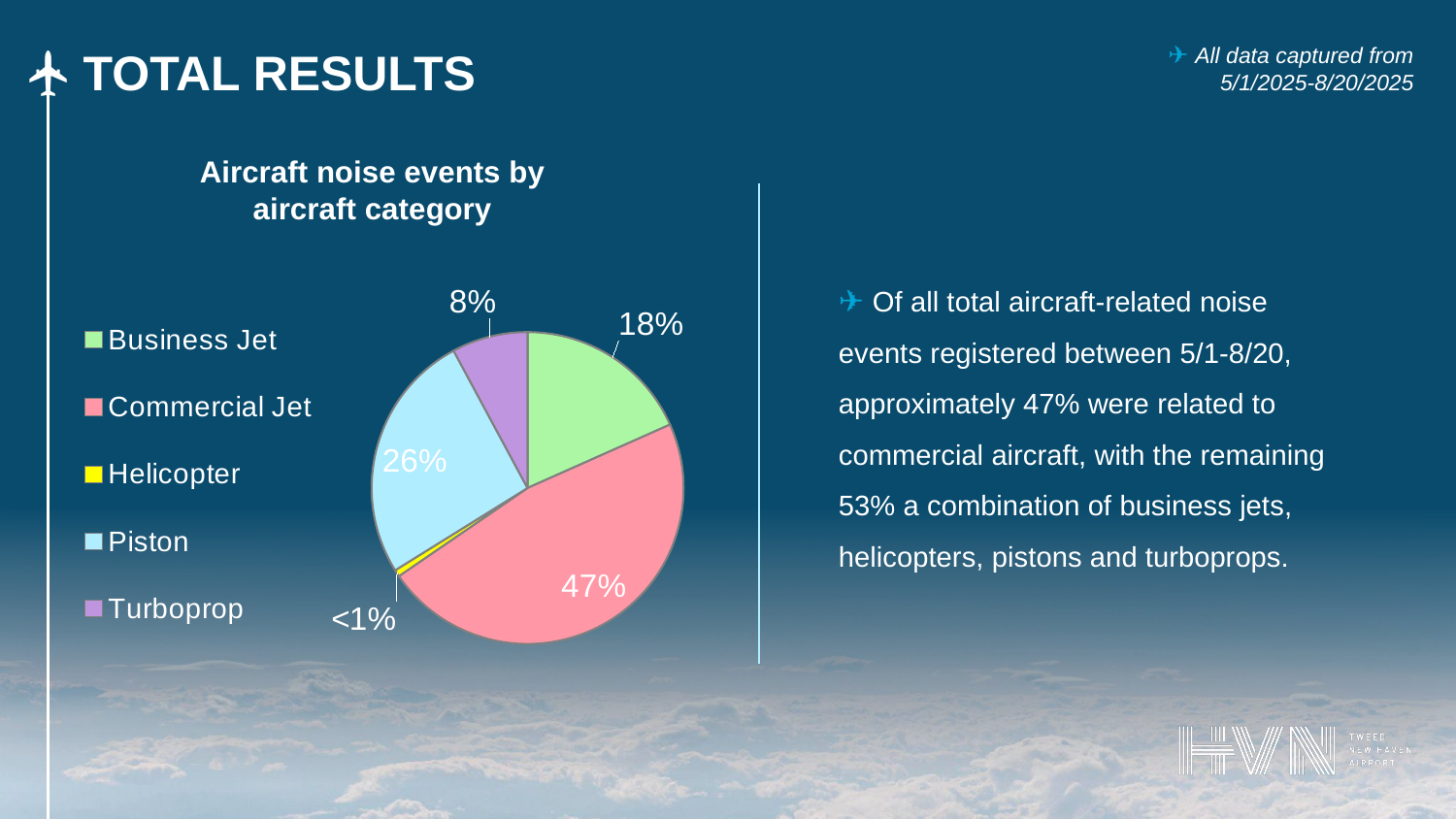
What share of aircraft noise events is attributed to Helicopter? <1% What share of aircraft noise events is attributed to Turboprop? 8% What is the difference in percentage points between the Commercial Jet and Piston shares? 21 What share of aircraft noise events is attributed to Business Jet? 18% Which has a larger share of noise events, Piston or Business Jet? Piston Which aircraft category has the largest share of noise events? Commercial Jet What kind of chart is shown on the slide? pie chart What is the title of the chart? Aircraft noise events by aircraft category How many aircraft categories does the legend list? 5 Which aircraft category has the smallest share of noise events? Helicopter